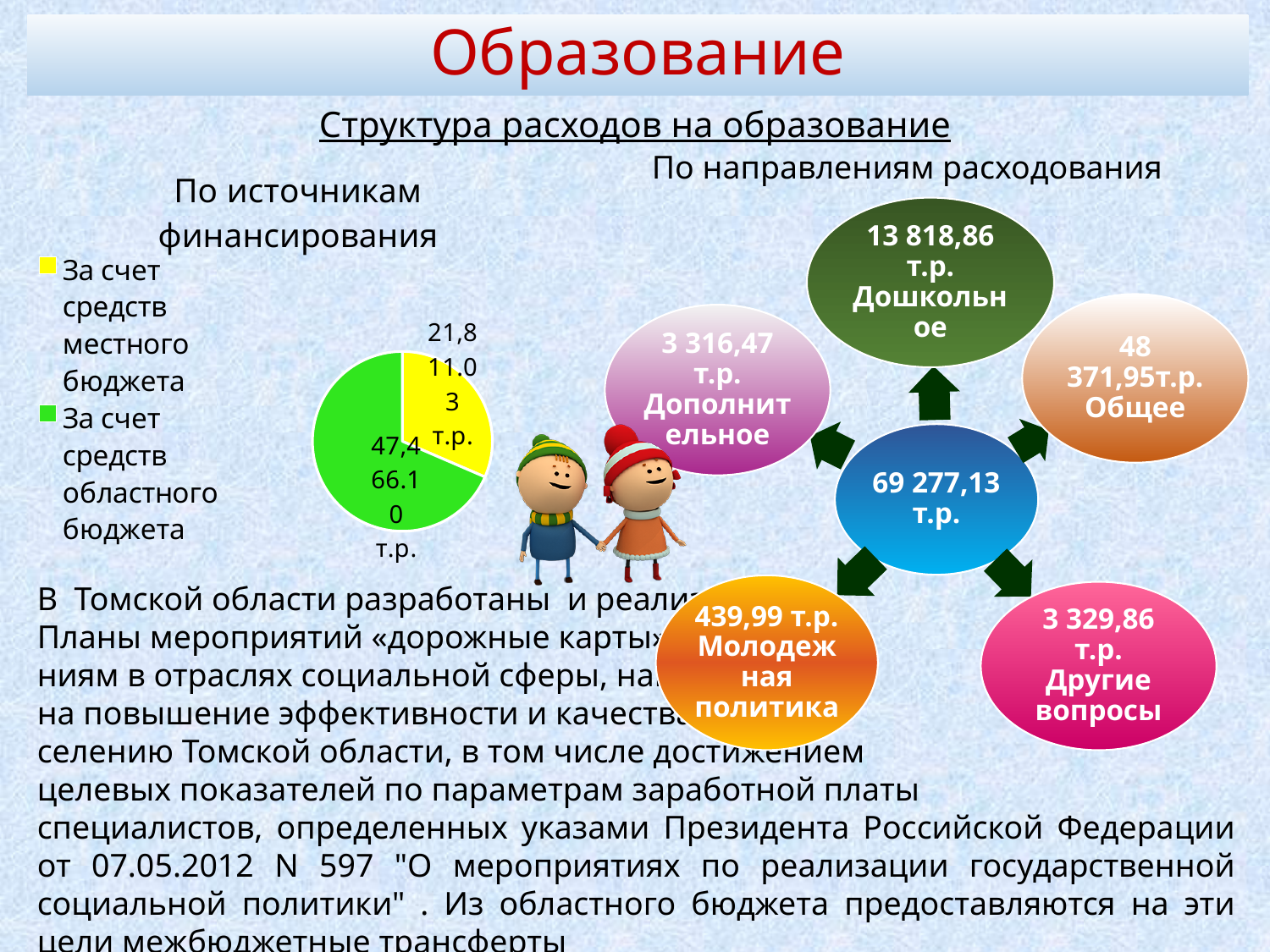
How many entries does the legend of the pie chart "По источникам финансирования" list? 2 In the pie chart "По источникам финансирования", what colour is the slice for "За счет средств областного бюджета"? green What kind of chart is shown under the heading "По источникам финансирования"? pie chart In the pie chart "По источникам финансирования", which is larger: the slice for "За счет средств местного бюджета" or the slice for "За счет средств областного бюджета"? За счет средств областного бюджета In the pie chart "По источникам финансирования", which source accounts for the largest slice? За счет средств областного бюджета In the pie chart "По источникам финансирования", what colour is the slice for "За счет средств местного бюджета"? yellow How many slices does the pie chart "По источникам финансирования" have? 2 In the pie chart "По источникам финансирования", which source accounts for the smallest slice? За счет средств местного бюджета